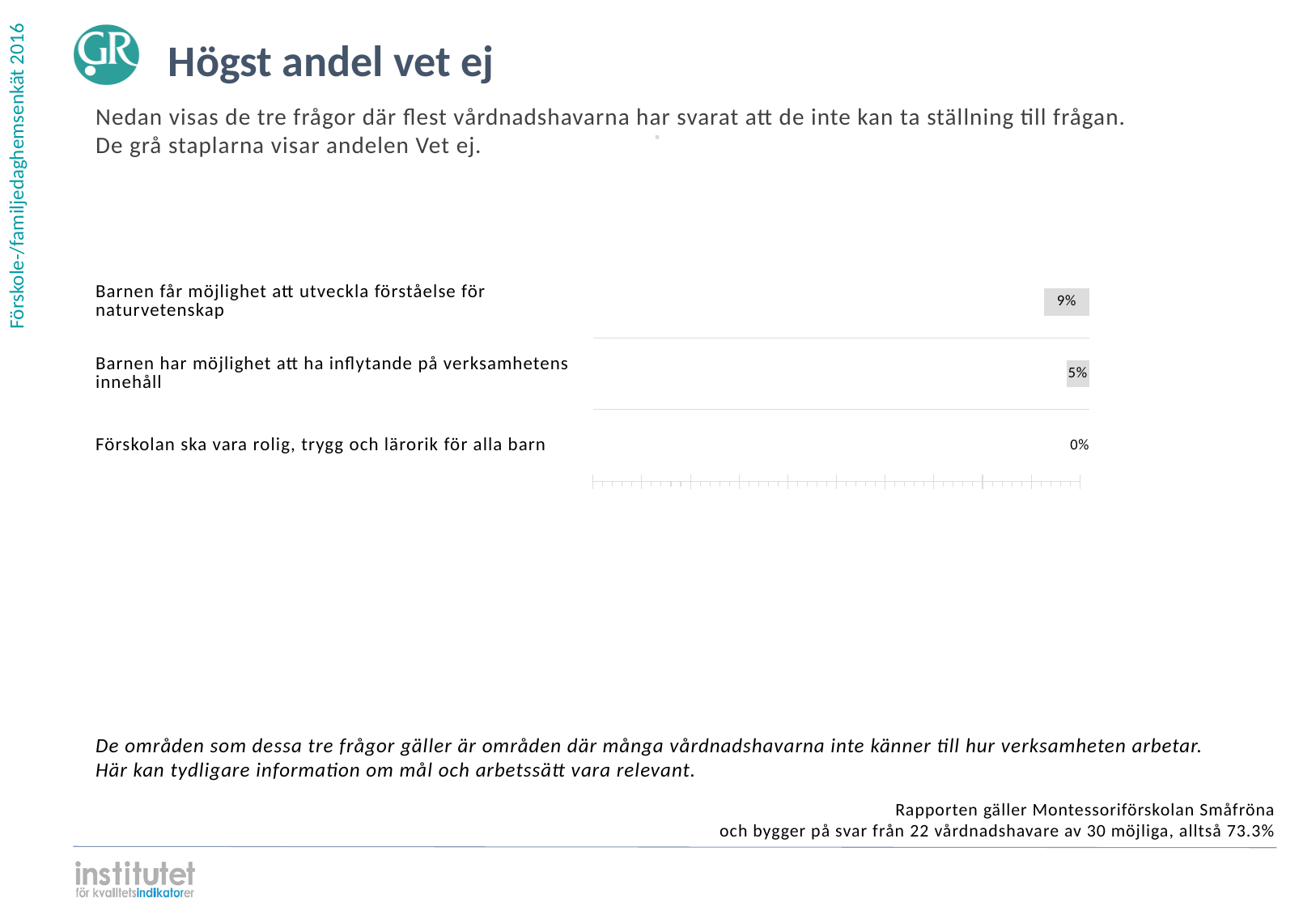
What is the difference between the values for "Barnen får möjlighet att utveckla förståelse för naturvetenskap" and "Barnen har möjlighet att ha inflytande på verksamhetens innehåll"? 4% Which category has the highest value? Barnen får möjlighet att utveckla förståelse för naturvetenskap What is the value for "Barnen har möjlighet att ha inflytande på verksamhetens innehåll"? 5% Which is larger: the value for "Barnen har möjlighet att ha inflytande på verksamhetens innehåll" or the value for "Förskolan ska vara rolig, trygg och lärorik för alla barn"? Barnen har möjlighet att ha inflytande på verksamhetens innehåll How many categories are shown in the chart? 3 What colour are the bars in the chart? Grey What is the title of the slide containing the chart? Högst andel vet ej What is the value for "Förskolan ska vara rolig, trygg och lärorik för alla barn"? 0% What is the value for "Barnen får möjlighet att utveckla förståelse för naturvetenskap"? 9% What kind of chart is shown on the slide? Bar chart Which category has the lowest value? Förskolan ska vara rolig, trygg och lärorik för alla barn